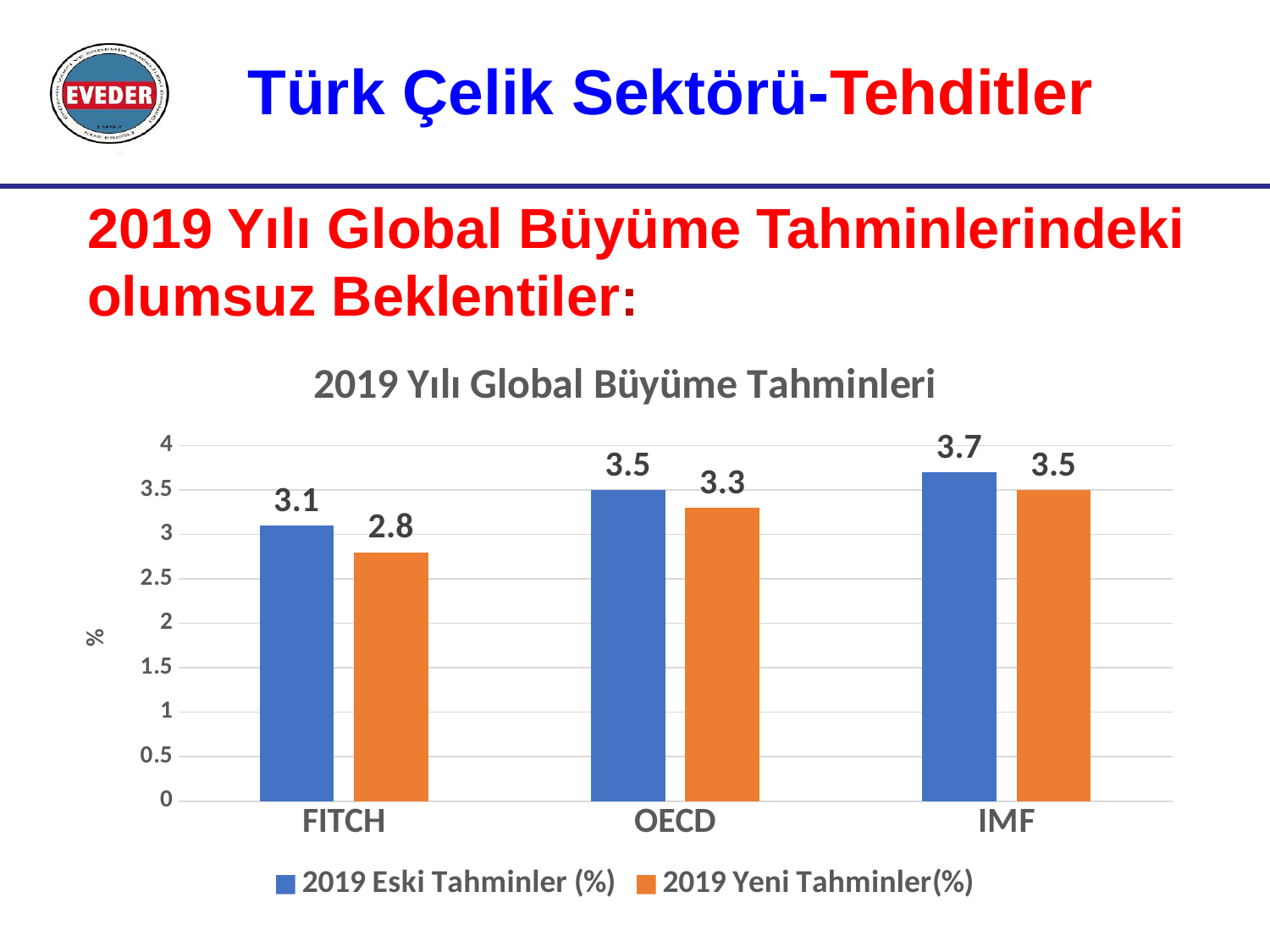
What is the value of 2019 Eski Tahminler (%) for FITCH? 3.1 Which category has the highest value for 2019 Eski Tahminler (%)? IMF How many series does the legend list? 2 What is the value of 2019 Yeni Tahminler(%) for IMF? 3.5 Which category has the lowest value for 2019 Yeni Tahminler(%)? FITCH What kind of chart is shown on the slide? Bar chart Which is larger for OECD: 2019 Eski Tahminler (%) or 2019 Yeni Tahminler(%)? 2019 Eski Tahminler (%) What is the title of the chart? 2019 Yılı Global Büyüme Tahminleri What is the difference between the 2019 Eski Tahminler (%) and 2019 Yeni Tahminler(%) values for FITCH? 0.3 What is the difference between the IMF and OECD values for 2019 Eski Tahminler (%)? 0.2 What is the value of 2019 Yeni Tahminler(%) for OECD? 3.3 How many categories are shown on the x axis? 3